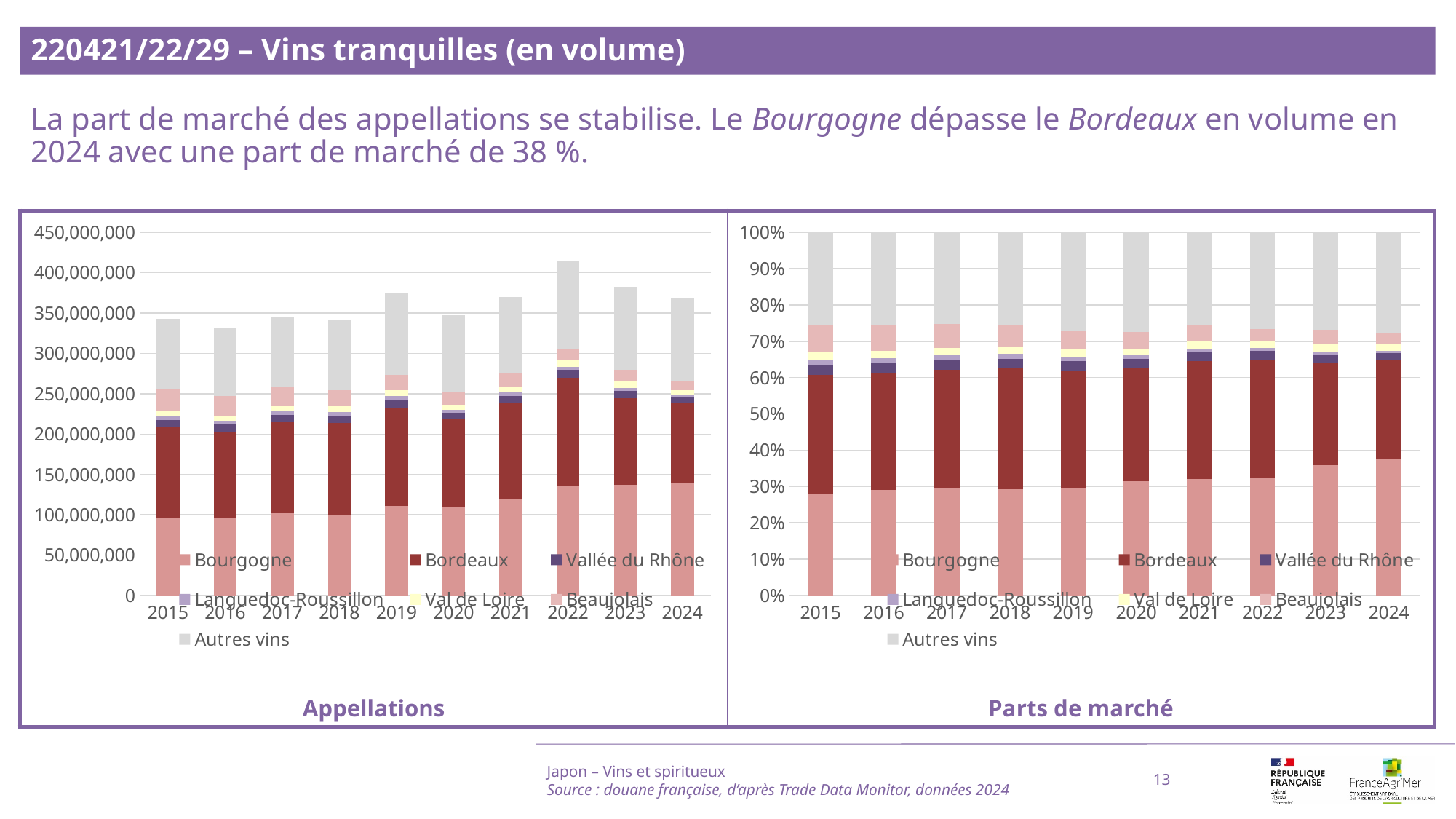
In the "Parts de marché" chart, does the Bourgogne share rise or fall from 2015 to 2024? Rises How many years are shown on the x axis of the "Parts de marché" chart? 10 In the "Appellations" chart, which year has the tallest stacked bar? 2022 In the "Appellations" chart, is the total stacked bar for 2022 greater or less than 400,000,000? greater In the "Appellations" chart, which year has the shortest stacked bar? 2016 Which series is shown in light grey at the top of each bar in both charts? Autres vins In the "Parts de marché" chart, is the Bourgogne share for 2024 greater or less than 30%? greater In the "Appellations" chart, is the Bourgogne segment larger in 2024 or in 2015? 2024 In the "Appellations" chart, is the Bourgogne value for 2024 greater or less than 100,000,000? greater What is the title of the chart on the right side of the slide? Parts de marché How many series does the legend of the "Appellations" chart list? 7 What kind of chart is the "Appellations" chart? Stacked bar chart